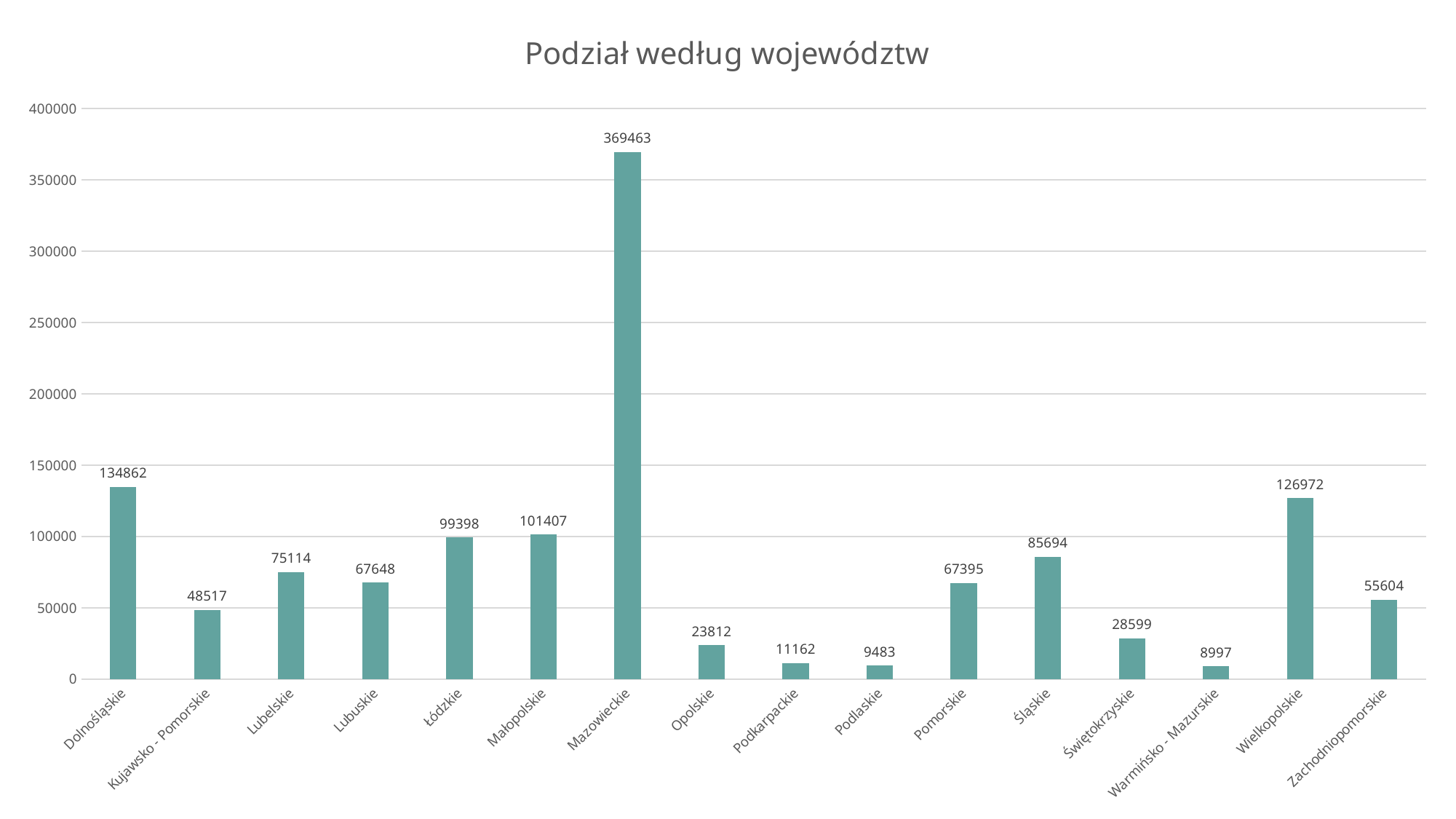
What is the difference between the values for Mazowieckie and Dolnośląskie? 234601 How many województwa are shown on the chart? 16 What is the value for Mazowieckie? 369463 Is the value for Śląskie greater or less than 50000? greater What is the value for Podkarpackie? 11162 What is the value for Wielkopolskie? 126972 What kind of chart is this? bar chart Which has a larger value, Lubelskie or Lubuskie? Lubelskie Which województwo has the highest value? Mazowieckie What is the title of the chart? Podział według województw Which województwo has the lowest value? Warmińsko - Mazurskie What is the difference between the values for Małopolskie and Łódzkie? 2009